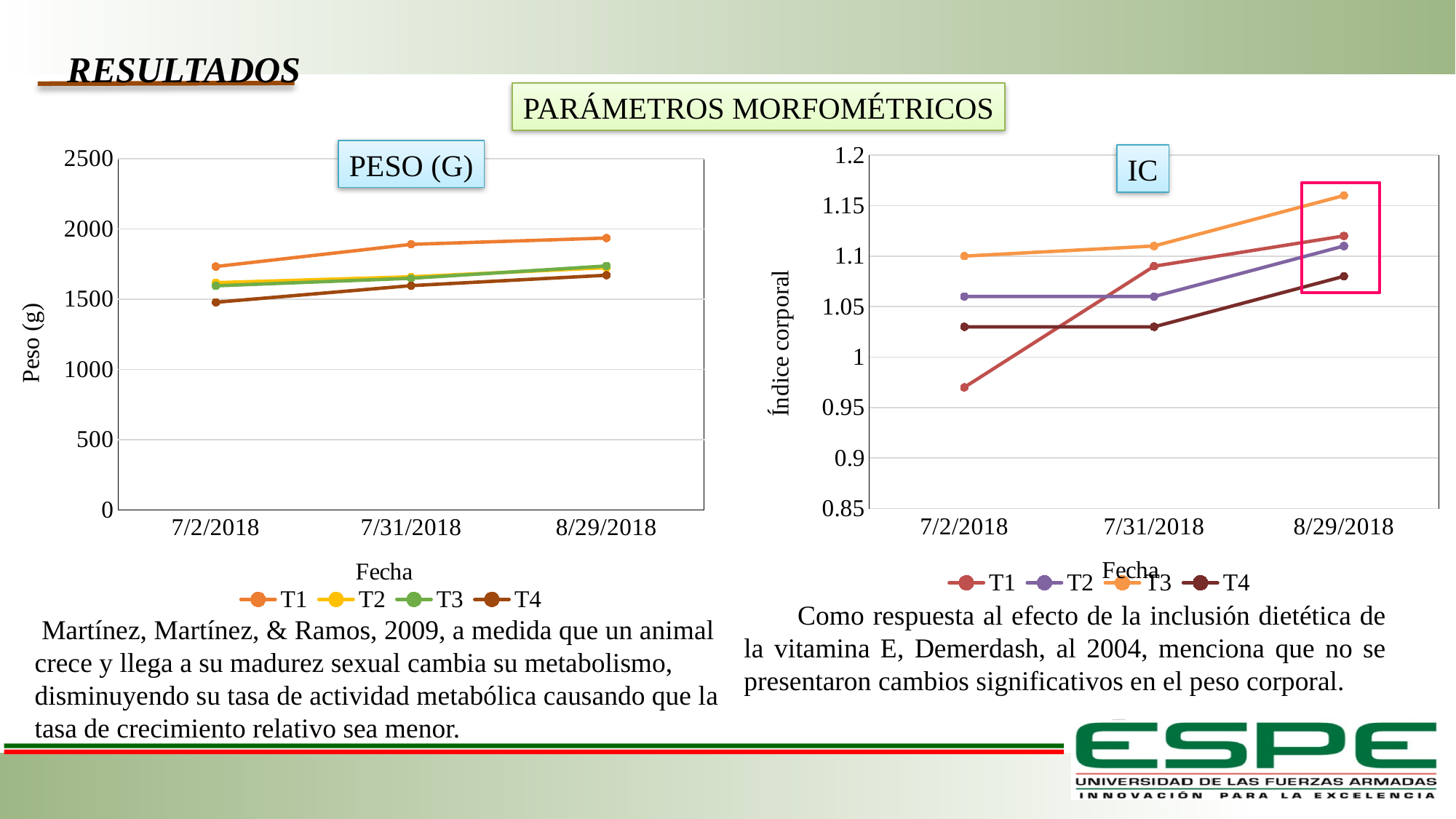
In the PESO (G) chart, is the value for T1 on 8/29/2018 greater or less than 1500? greater In the IC chart, is the value for T4 on 8/29/2018 greater or less than 1.05? greater In the IC chart, is the value for T1 on 7/2/2018 greater or less than 1? less How many dates are plotted along the x axis of the PESO (G) chart? 3 In the PESO (G) chart, which series has the lowest value on 7/2/2018? T4 In the PESO (G) chart, which series has the highest value on 8/29/2018? T1 In the IC chart, which series has the lowest value on 7/2/2018? T1 What kind of chart is the PESO (G) chart on the left? line chart In the IC chart, does the T1 series rise or fall from 7/2/2018 to 8/29/2018? rise How many series does the legend of the IC chart list? 4 What is the y-axis title of the IC chart? Índice corporal In the IC chart, which series has the highest value on 8/29/2018? T3